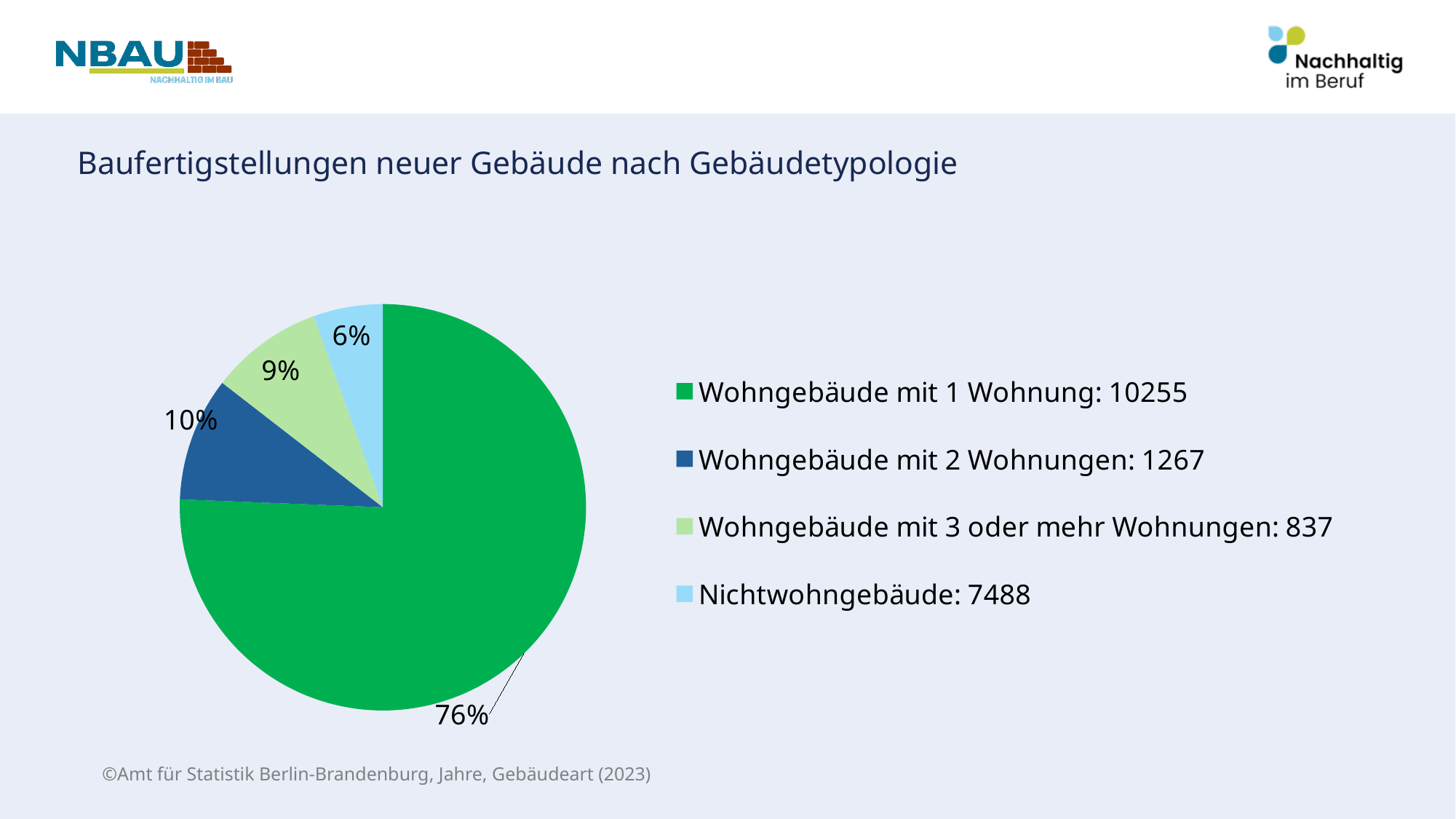
What percentage is shown on the slice for Wohngebäude mit 3 oder mehr Wohnungen? 9% What number is given in the legend for Wohngebäude mit 1 Wohnung? 10255 What percentage is shown on the slice for Wohngebäude mit 2 Wohnungen? 10% What share of the pie is labelled for the largest slice (Wohngebäude mit 1 Wohnung)? 76% Which category has the smallest slice of the pie? Nichtwohngebäude Which category has the largest slice of the pie? Wohngebäude mit 1 Wohnung What is the difference between the legend values for Wohngebäude mit 2 Wohnungen and Wohngebäude mit 3 oder mehr Wohnungen? 430 What kind of chart is shown on the slide? pie chart What number is given in the legend for Nichtwohngebäude? 7488 How many slices does the pie chart have? 4 What is the title of the chart? Baufertigstellungen neuer Gebäude nach Gebäudetypologie